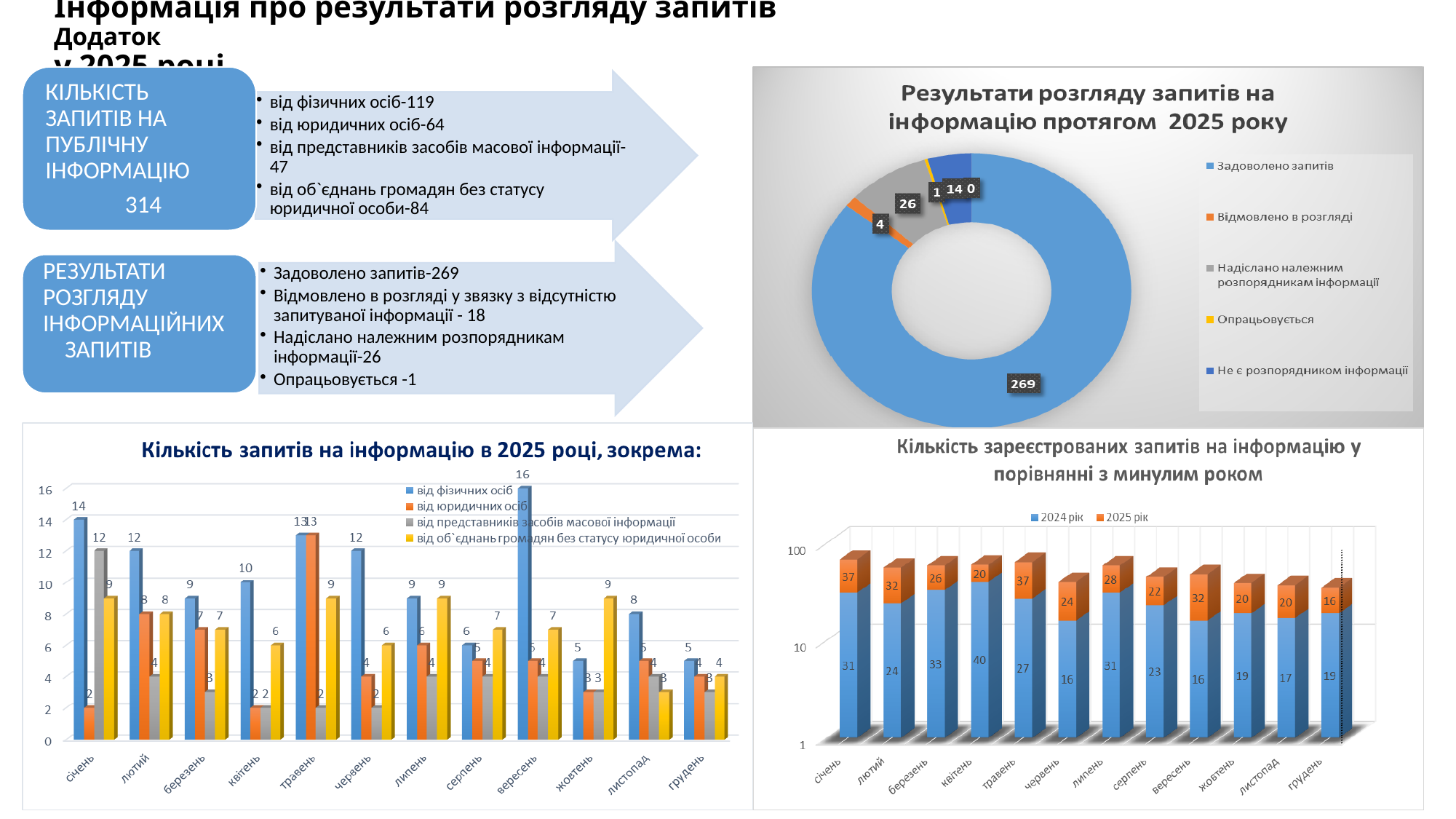
In the chart 'Кількість запитів на інформацію в 2025 році, зокрема:', what is the value for 'від фізичних осіб' in вересень? 16 In the chart 'Кількість запитів на інформацію в 2025 році, зокрема:', what is the difference between 'від фізичних осіб' and 'від юридичних осіб' in січень? 12 In the chart 'Кількість зареєстрованих запитів на інформацію у порівнянні з минулим роком', what is the value for '2024 рік' in квітень? 40 In the chart 'Кількість запитів на інформацію в 2025 році, зокрема:', how many series does the legend list? 4 In the chart 'Кількість зареєстрованих запитів на інформацію у порівнянні з минулим роком', which month has the lowest value for '2025 рік'? грудень In the chart 'Кількість зареєстрованих запитів на інформацію у порівнянні з минулим роком', which is larger in травень: '2024 рік' or '2025 рік'? 2025 рік In the chart 'Результати розгляду запитів на інформацію протягом 2025 року', what is the value for 'Задоволено запитів'? 269 What kind of chart is 'Результати розгляду запитів на інформацію протягом 2025 року'? Doughnut chart In the chart 'Кількість запитів на інформацію в 2025 році, зокрема:', how many months are shown on the x axis? 12 In the chart 'Кількість зареєстрованих запитів на інформацію у порівнянні з минулим роком', what is the total of the stacked bar for січень? 68 In the chart 'Результати розгляду запитів на інформацію протягом 2025 року', how many entries does the legend list? 5 In the chart 'Кількість запитів на інформацію в 2025 році, зокрема:', which month has the highest value for 'від фізичних осіб'? вересень